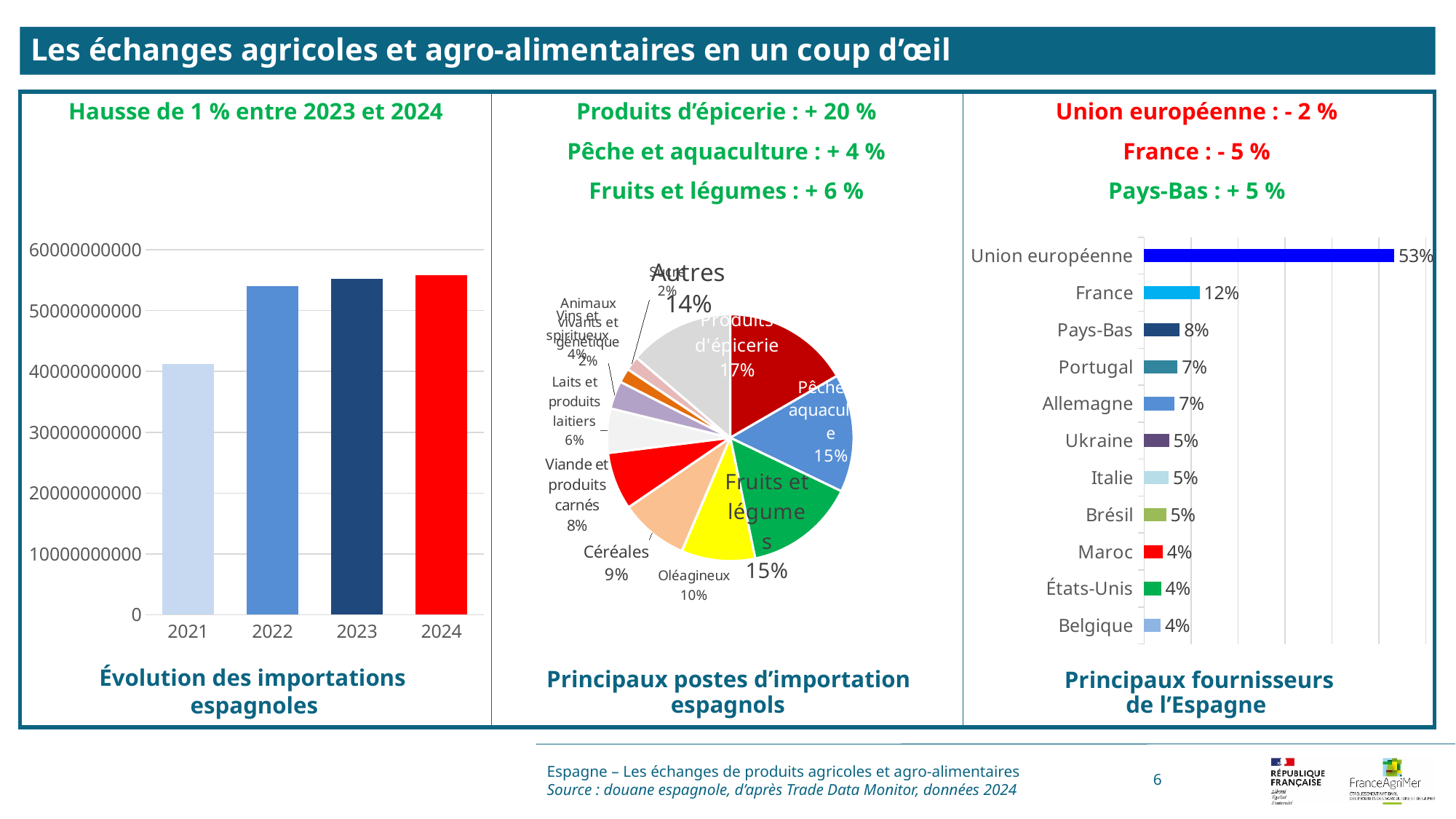
What kind of chart is 'Principaux postes d'importation espagnols'? Pie chart On the chart 'Principaux postes d'importation espagnols', which category has the largest slice? Produits d'épicerie On the chart 'Principaux fournisseurs de l'Espagne', what is the difference between the values for Union européenne and France? 41 percentage points On the chart 'Principaux fournisseurs de l'Espagne', which supplier has the highest share? Union européenne On the chart 'Évolution des importations espagnoles', which year has the lowest value? 2021 On the chart 'Évolution des importations espagnoles', do the values rise or fall from 2021 to 2024? Rise On the chart 'Évolution des importations espagnoles', is the value for 2021 greater or less than 50000000000? less On the chart 'Principaux fournisseurs de l'Espagne', what is the value for France? 12% On the chart 'Principaux postes d'importation espagnols', what is the share of Laits et produits laitiers? 6% On the chart 'Principaux postes d'importation espagnols', what share does Céréales represent? 9% On the chart 'Principaux fournisseurs de l'Espagne', which is larger, the value for Pays-Bas or the value for Portugal? Pays-Bas On the chart 'Principaux fournisseurs de l'Espagne', how many suppliers are listed? 11